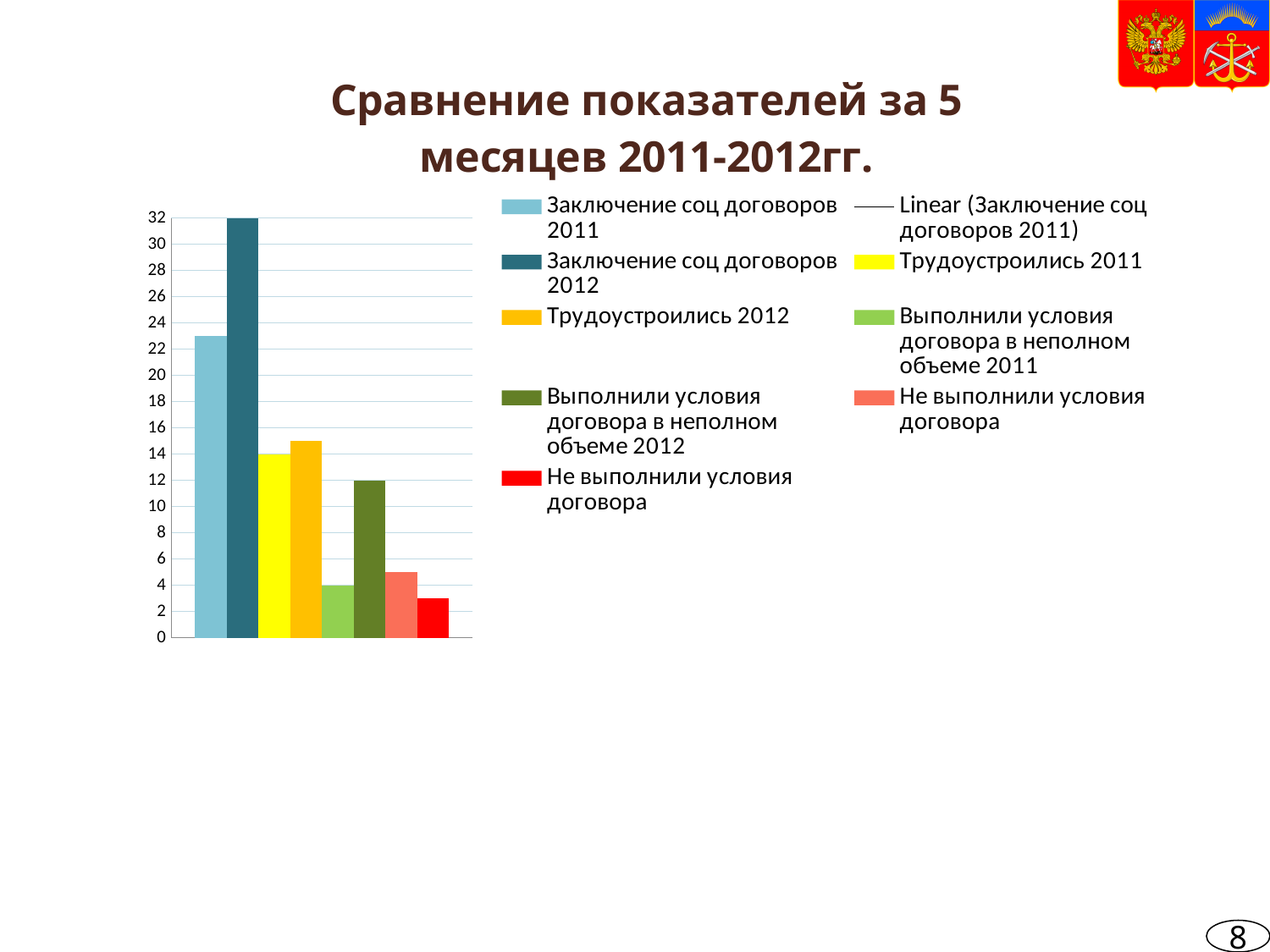
What is the title of the slide? Сравнение показателей за 5 месяцев 2011-2012гг. How many entries does the legend list? 9 Is the value for Трудоустроились 2012 greater or less than 10? greater What is the value for Выполнили условия договора в неполном объеме 2012? 12 Which is larger: Заключение соц договоров 2011 or Заключение соц договоров 2012? Заключение соц договоров 2012 What kind of chart is shown on the slide? bar chart Which series has the highest value in the chart? Заключение соц договоров 2012 What is the value for Трудоустроились 2011? 14 What is the difference between Выполнили условия договора в неполном объеме 2012 and Выполнили условия договора в неполном объеме 2011? 8 Is the value for Заключение соц договоров 2011 greater or less than 20? greater What is the value for Заключение соц договоров 2012? 32 What is the value for Выполнили условия договора в неполном объеме 2011? 4